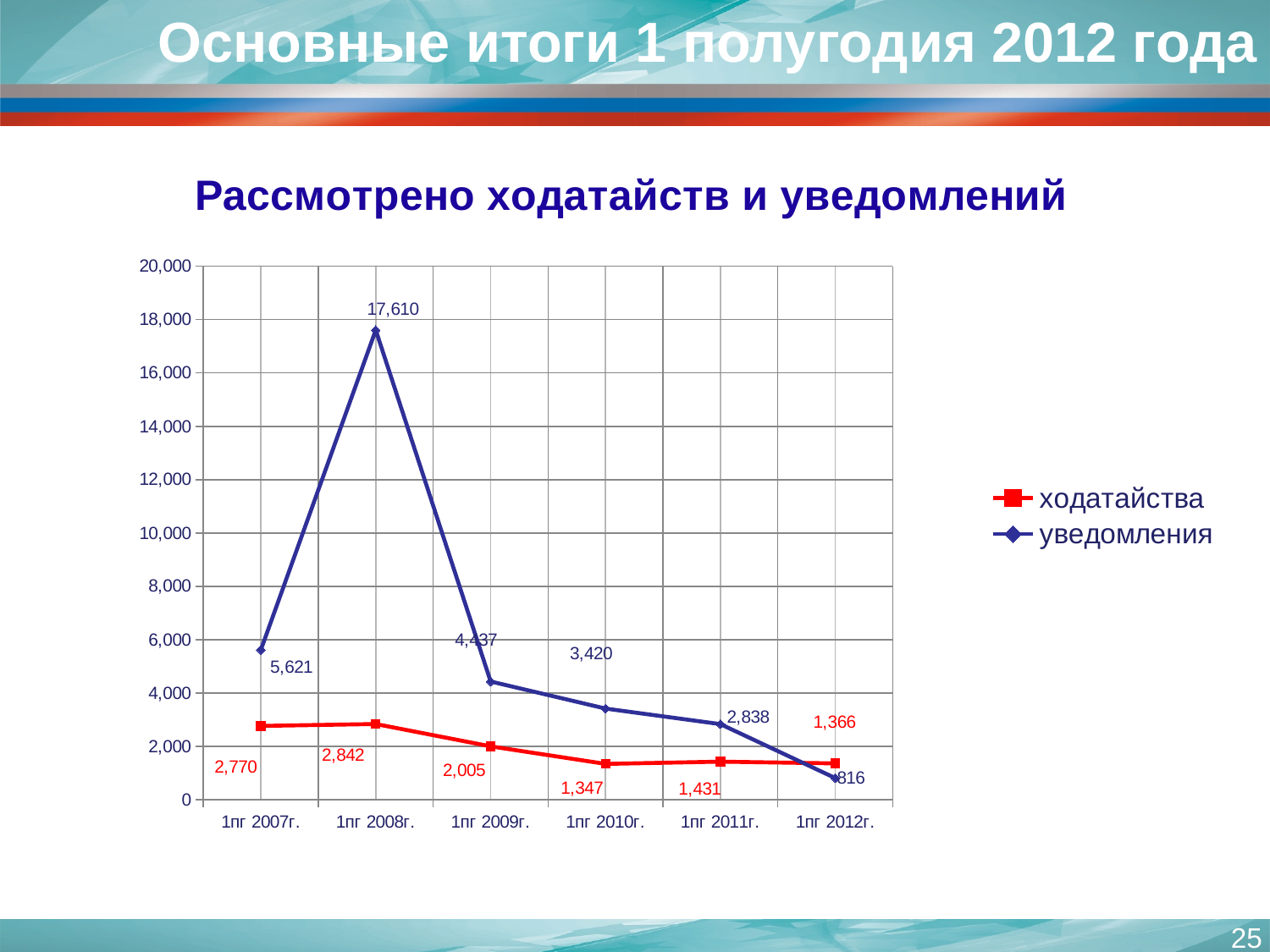
Does the value for уведомления rise or fall from 1пг 2009г. to 1пг 2012г.? fall In which period is the value for ходатайства lowest? 1пг 2010г. What is the value for уведомления in 1пг 2008г.? 17,610 What is the difference between уведомления and ходатайства in 1пг 2007г.? 2,851 Which is larger in 1пг 2012г., ходатайства or уведомления? ходатайства How many periods are shown on the x axis? 6 How many series does the legend list? 2 What is the value for ходатайства in 1пг 2010г.? 1,347 What is the title of the chart? Рассмотрено ходатайств и уведомлений What is the value for уведомления in 1пг 2012г.? 816 In which period is the value for уведомления highest? 1пг 2008г. What type of chart is shown on the slide? line chart